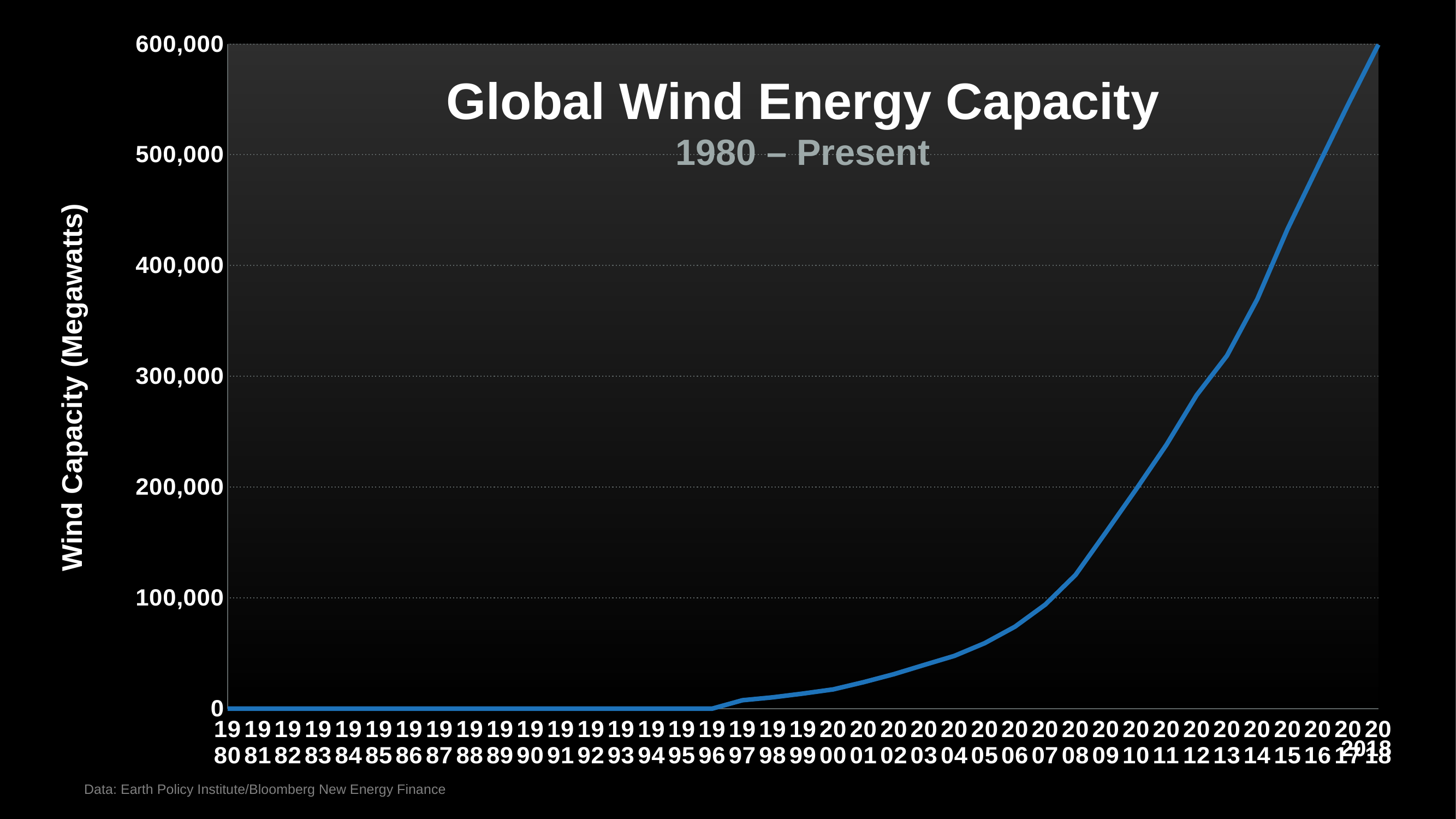
What kind of chart is shown on the slide? line chart What is the title of the chart? Global Wind Energy Capacity Does wind capacity generally rise or fall from 1980 to 2018 in the chart? rise Which year has the highest wind capacity in the chart? 2018 Is the wind capacity for 2018 greater or less than 500,000? greater Is the wind capacity for 2000 greater or less than 100,000? less What is the label on the vertical axis of the chart? Wind Capacity (Megawatts) Is the wind capacity for 2005 greater or less than 100,000? less Which year has the larger wind capacity, 2008 or 2014? 2014 How many years are plotted along the x axis of the chart? 39